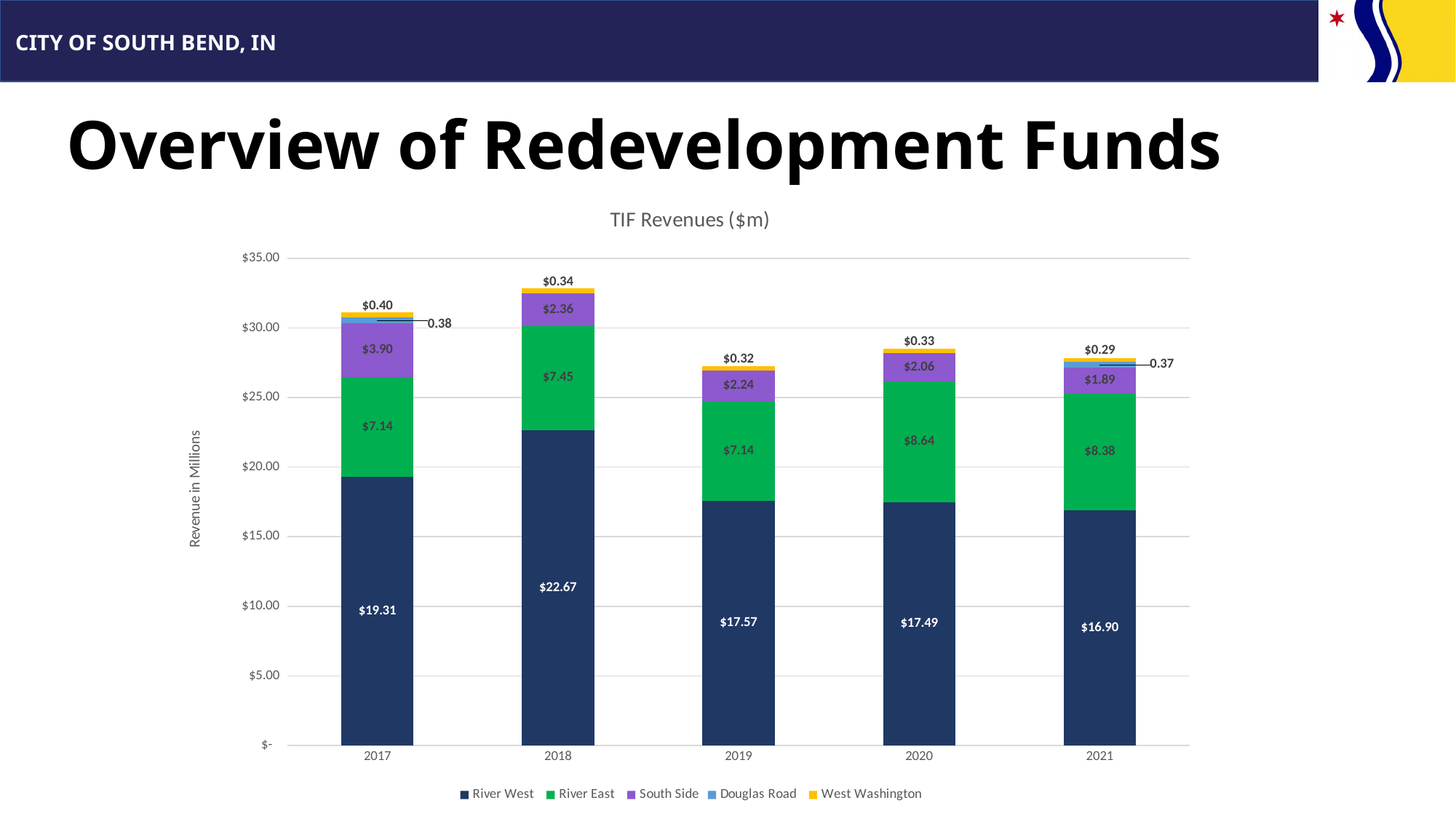
What kind of chart is shown on the slide? Stacked bar chart What is the South Side value for 2017? $3.90 What is the River West value for 2018? $22.67 What is the West Washington value for 2021? $0.29 How many years are shown on the x axis? 5 Does the South Side value rise or fall from 2018 to 2021? Fall In which year is the River West value lowest? 2021 Which year has the larger River East value, 2018 or 2021? 2021 What is the Douglas Road value for 2021? 0.37 In which year is the River West value highest? 2018 What is the difference between the River East values for 2020 and 2019? $1.50 How many series does the legend list? 5